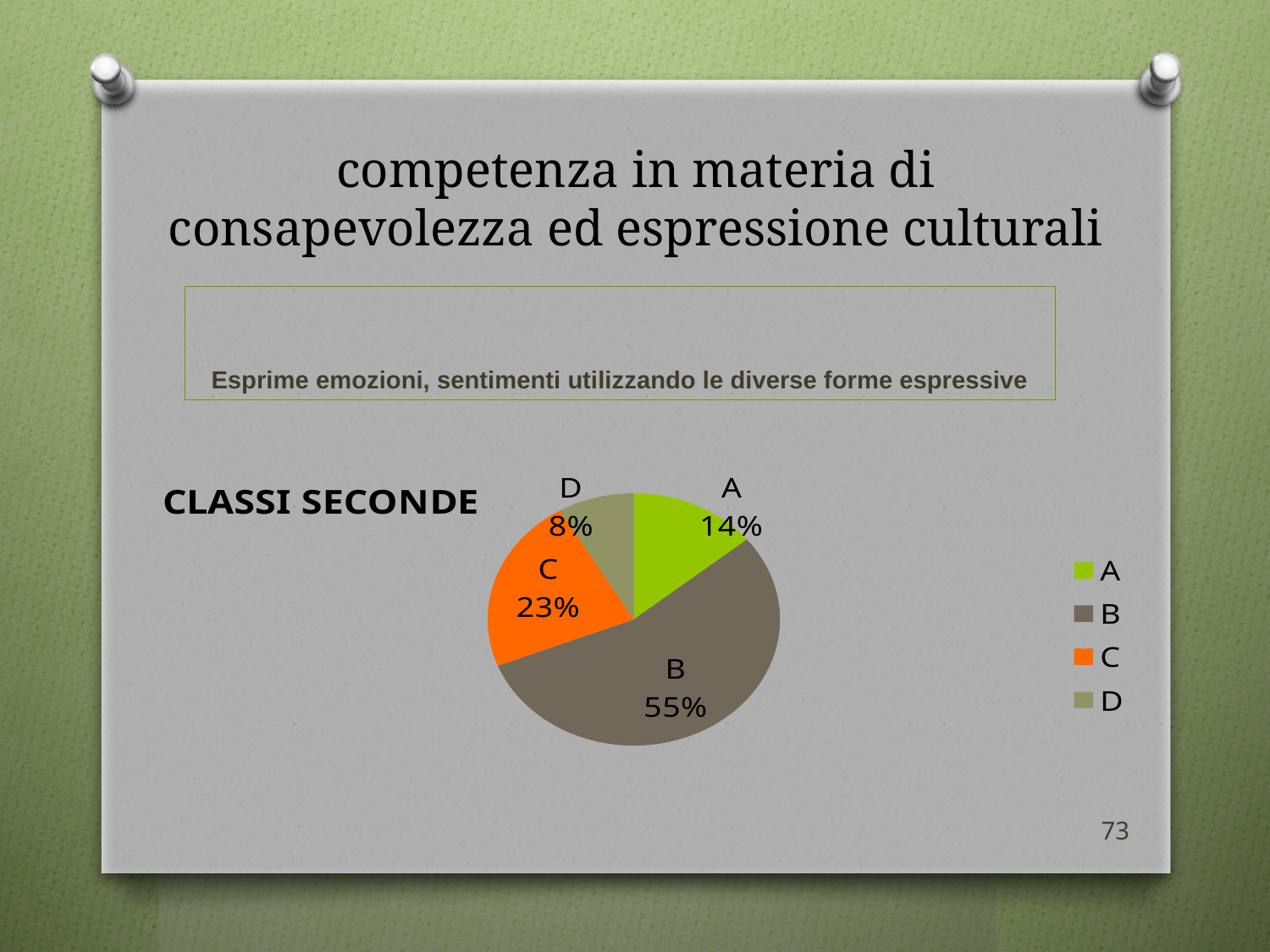
What colour is slice C in the pie chart? orange Which is larger, slice A or slice C? C What kind of chart is shown on the slide? pie chart What percentage does slice A represent in the pie chart? 14% Which slice of the pie chart is the largest? B How many entries does the legend list? 4 How many slices does the pie chart have? 4 Which slice of the pie chart is the smallest? D What percentage does slice D represent in the pie chart? 8% What percentage does slice B represent in the pie chart? 55% What is the difference in percentage points between slice B and slice C? 32 What percentage does slice C represent in the pie chart? 23%